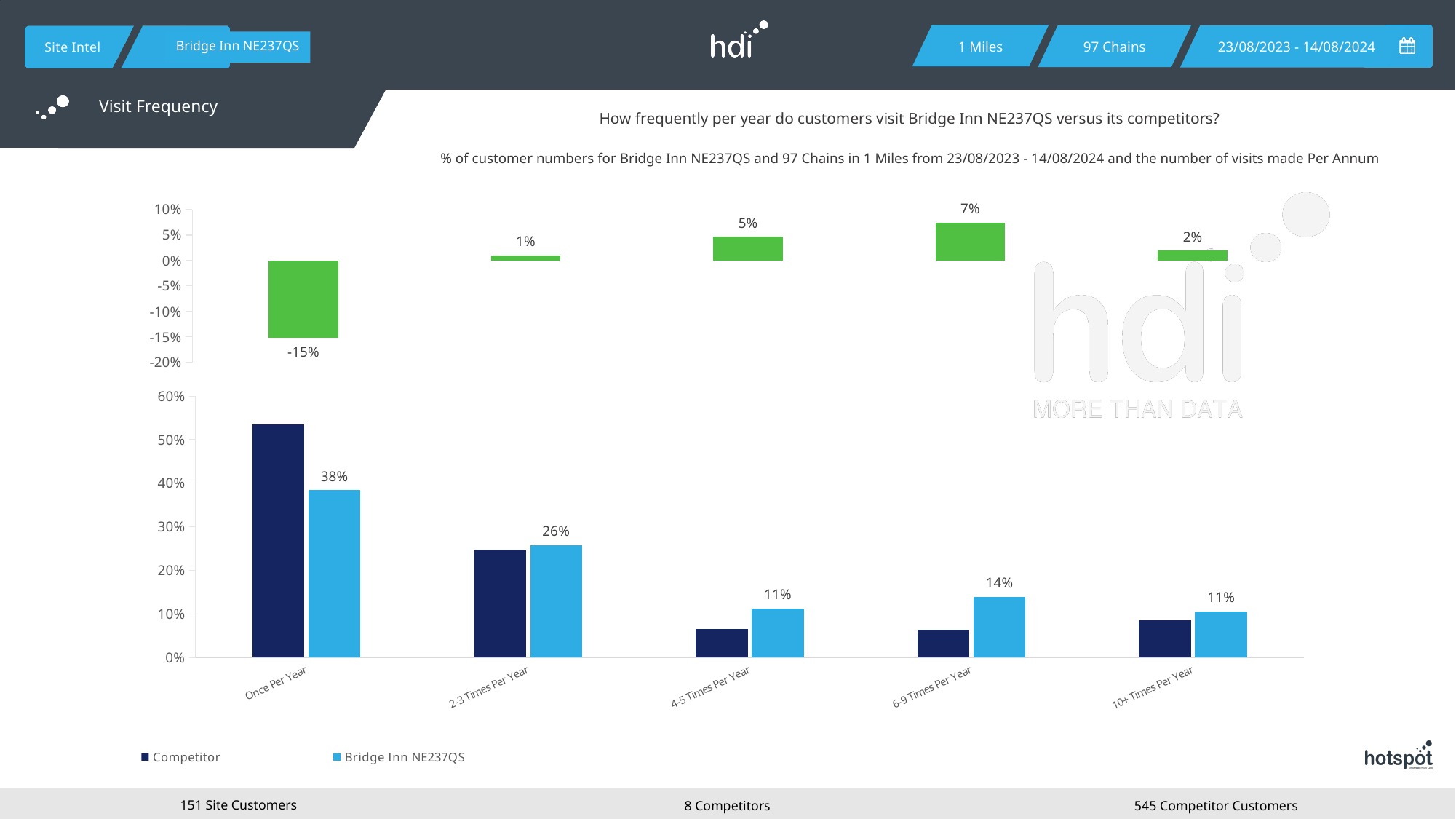
In the bottom chart, what is the value for Bridge Inn NE237QS for Once Per Year? 38% In the top chart (green bars), what is the value for 6-9 Times Per Year? 7% In the bottom chart, is the Competitor value for Once Per Year greater or less than 50%? greater How many categories are shown on the x axis of the bottom chart? 5 In the top chart (green bars), what is the value for Once Per Year? -15% In the bottom chart, which is larger for 6-9 Times Per Year: Competitor or Bridge Inn NE237QS? Bridge Inn NE237QS In the top chart (green bars), which category has the lowest value? Once Per Year How many series does the legend of the bottom chart list? 2 In the top chart (green bars), what is the difference between the values for 4-5 Times Per Year and 2-3 Times Per Year? 4% In the top chart (green bars), which category has the highest value? 6-9 Times Per Year In the bottom chart, what is the value for Bridge Inn NE237QS for 6-9 Times Per Year? 14% In the bottom chart, which is larger for Once Per Year: Competitor or Bridge Inn NE237QS? Competitor